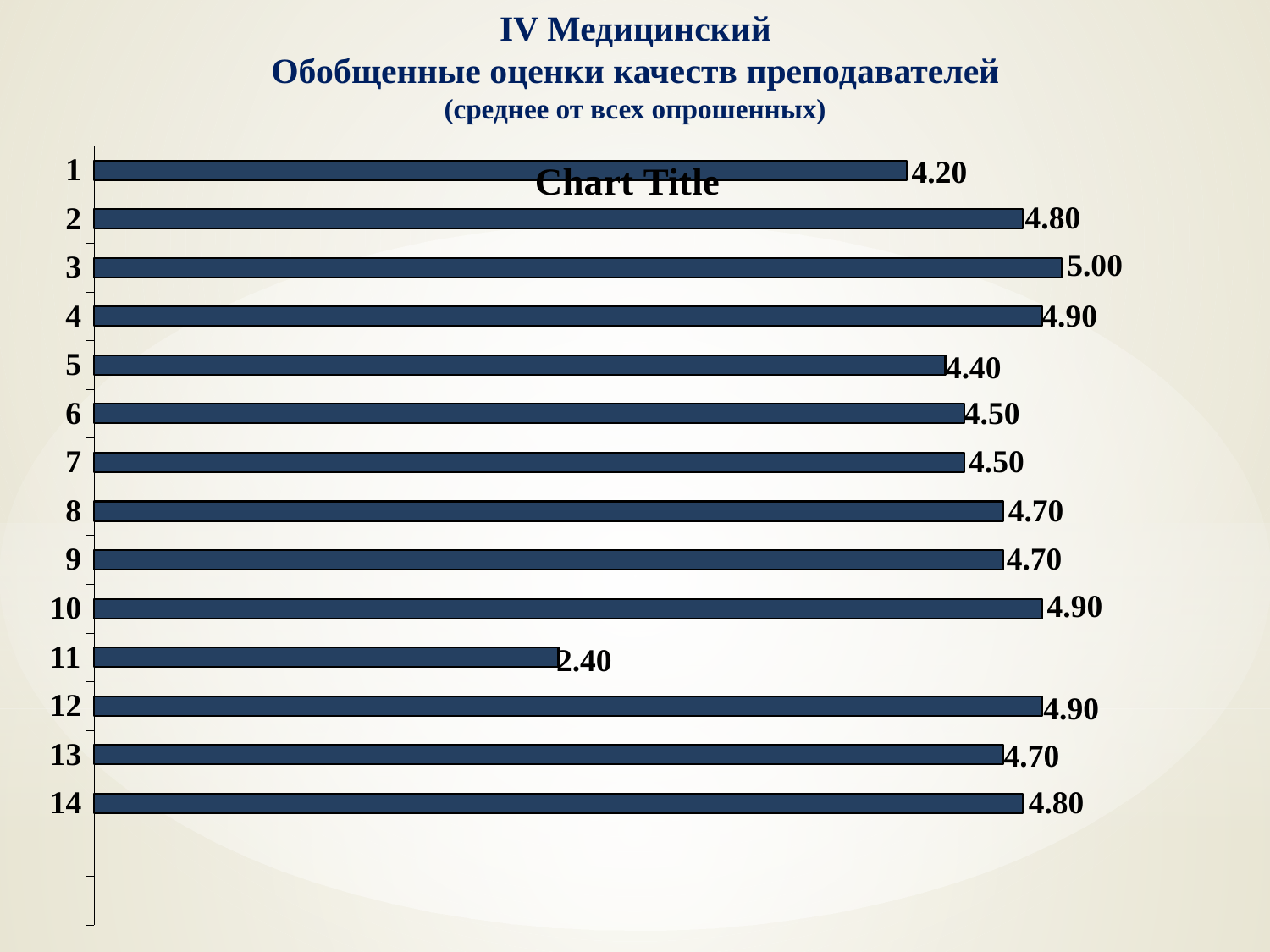
What is the value for category 11? 2.40 What is the value for category 14? 4.80 Which category has the lowest value? 11 How many categories are plotted in the chart? 14 What kind of chart is shown on the slide? bar chart What is the value for category 1? 4.20 What title is printed inside the chart area? Chart Title What is the difference between the values for category 3 and category 11? 2.60 Which is larger, the value for category 5 or the value for category 8? category 8 Which category has the highest value? 3 What is the value for category 3? 5.00 What is the difference between the values for category 2 and category 1? 0.60